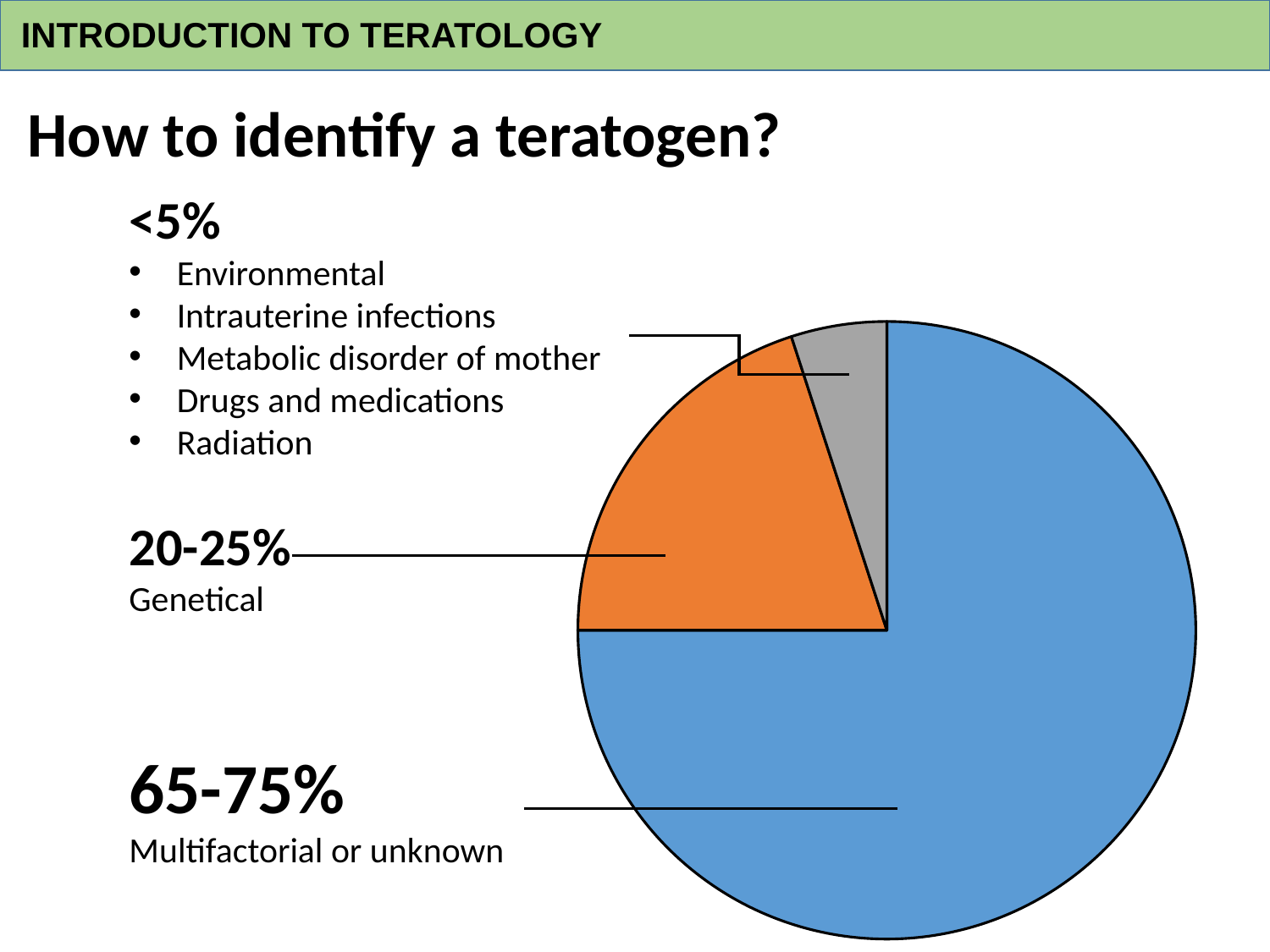
What colour is the slice for Genetical? orange Which category has the largest slice of the pie? Multifactorial or unknown Which category has the smallest slice of the pie? the <5% group (Environmental, Intrauterine infections, Metabolic disorder of mother, Drugs and medications, Radiation) What colour is the slice for Multifactorial or unknown? blue Which slice is larger: Genetical or the <5% environmental group? Genetical How many slices does the pie chart have? 3 What share of the pie is labelled for the group including Environmental, Intrauterine infections, Drugs and medications and Radiation? <5% What share of the pie is labelled as Genetical? 20-25% What share of the pie is labelled as Multifactorial or unknown? 65-75% What type of chart is shown on the slide? pie chart Which slice is larger: Genetical or Multifactorial or unknown? Multifactorial or unknown